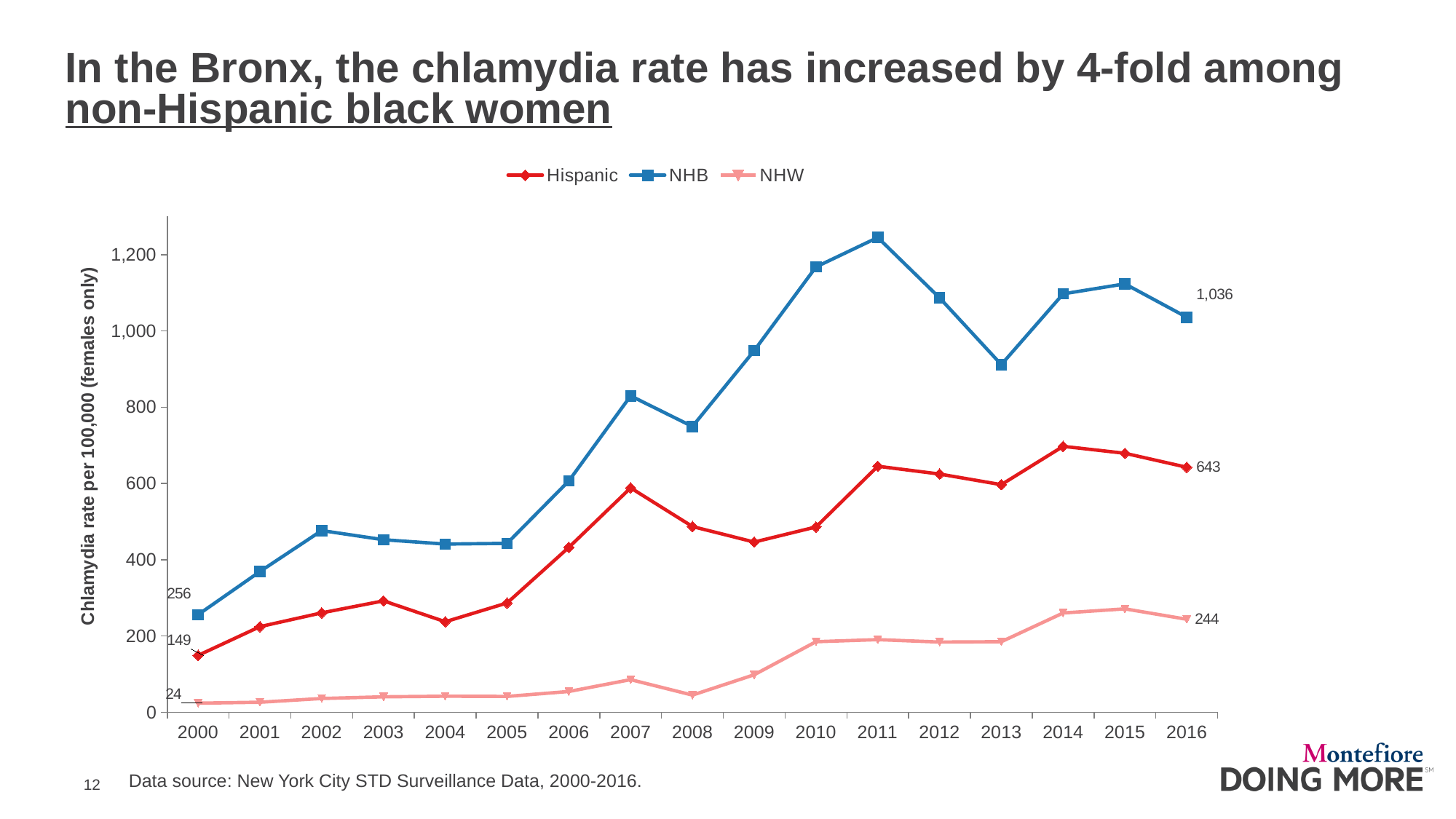
Is the NHB value for 2008 greater or less than 800? less What is the chlamydia rate for NHW in 2016? 244 What is the difference between the Hispanic rate in 2016 and in 2000? 494 What is the chlamydia rate for Hispanic women in 2000? 149 Is the NHB value for 2011 greater or less than 1,200? greater How many series does the legend list? 3 By how much did the NHB chlamydia rate increase from 2000 to 2016? 780 What kind of chart is shown on the slide? Line chart What is the chlamydia rate for NHB in 2016? 1,036 Which series has the highest chlamydia rate in 2016? NHB In which year does the NHB line reach its highest value? 2011 What is the chlamydia rate for NHW in 2000? 24